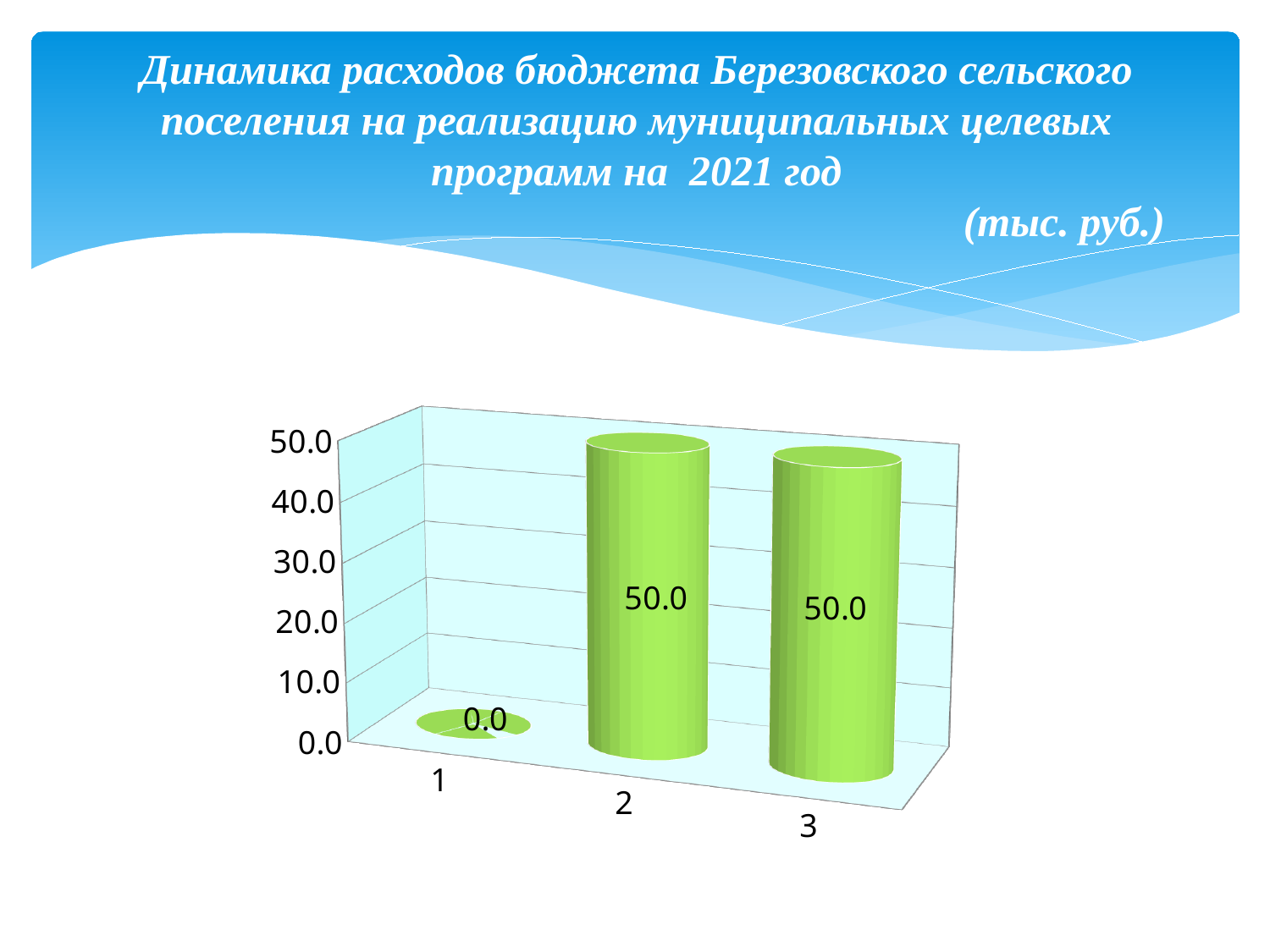
Is the value for category 2 greater or less than 30.0? greater What is the value for category 2? 50.0 Do the values rise or fall from category 1 to category 2? rise Which category has the lowest value? 1 What is the highest tick value shown on the vertical axis? 50.0 How many categories are shown on the x axis? 3 What kind of chart is shown on the slide? bar chart What is the value for category 1? 0.0 What is the value for category 3? 50.0 What is the difference between the values for category 2 and category 1? 50.0 In what units are the values on the slide expressed, according to the title? тыс. руб. Which is larger, the value for category 1 or the value for category 3? 3